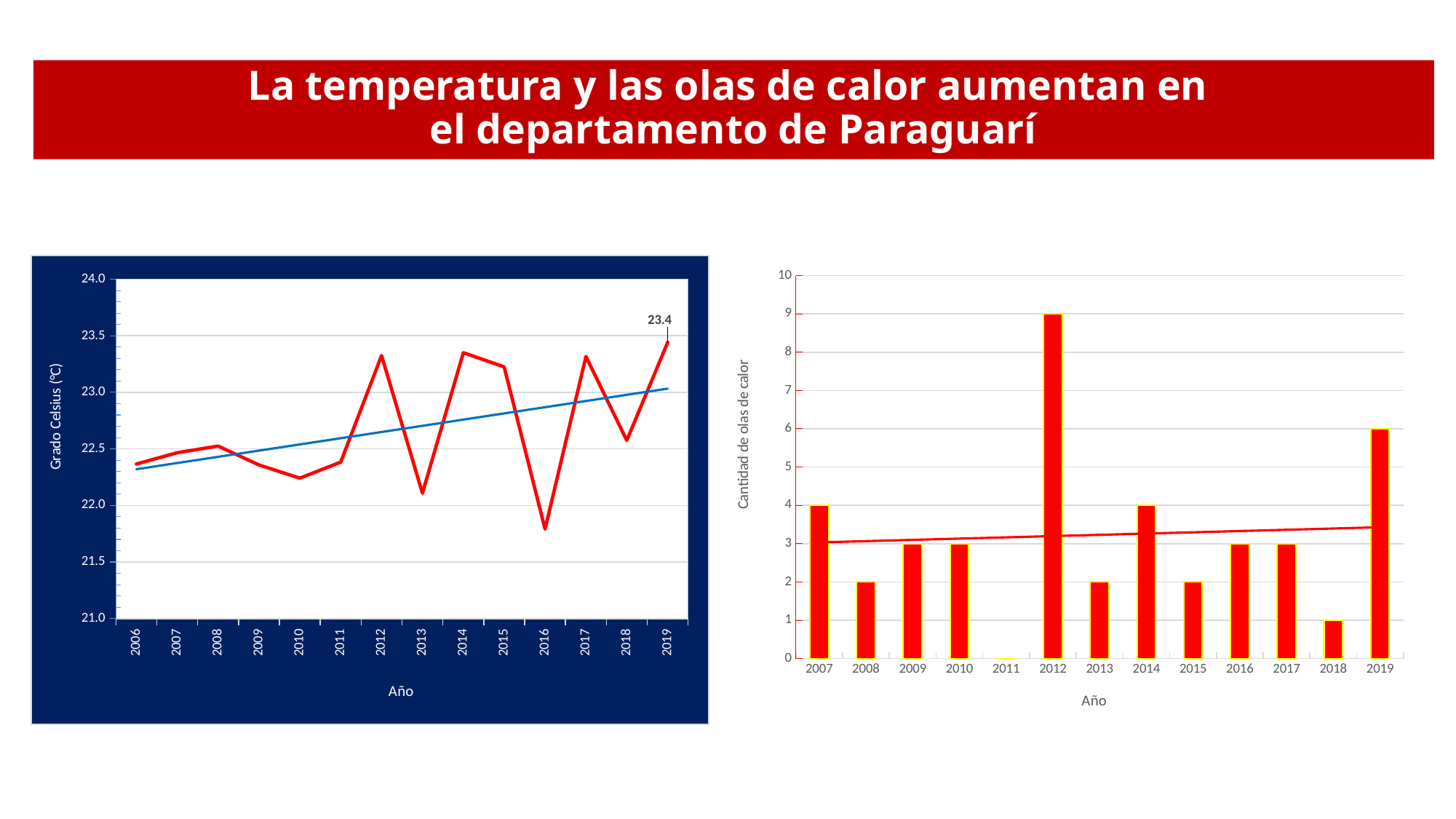
What kind of chart is the right chart? bar chart On the right chart, which is larger, the value for 2007 or the value for 2008? 2007 On the right chart, how many heat waves are shown for 2012? 9 On the left chart, is the value for 2012 greater or less than 23.0? greater On the right chart, which year has the lowest number of heat waves? 2011 What kind of chart is the left chart? line chart On the right chart, what is the difference between the values for 2012 and 2019? 3 On the right chart, how many years are shown on the x axis? 13 On the left chart, what temperature value is labelled for 2019? 23.4 On the right chart, which year has the highest number of heat waves? 2012 On the left chart, is the value for 2016 greater or less than 22.0? less On the left chart, what is the label of the y axis? Grado Celsius (°C)